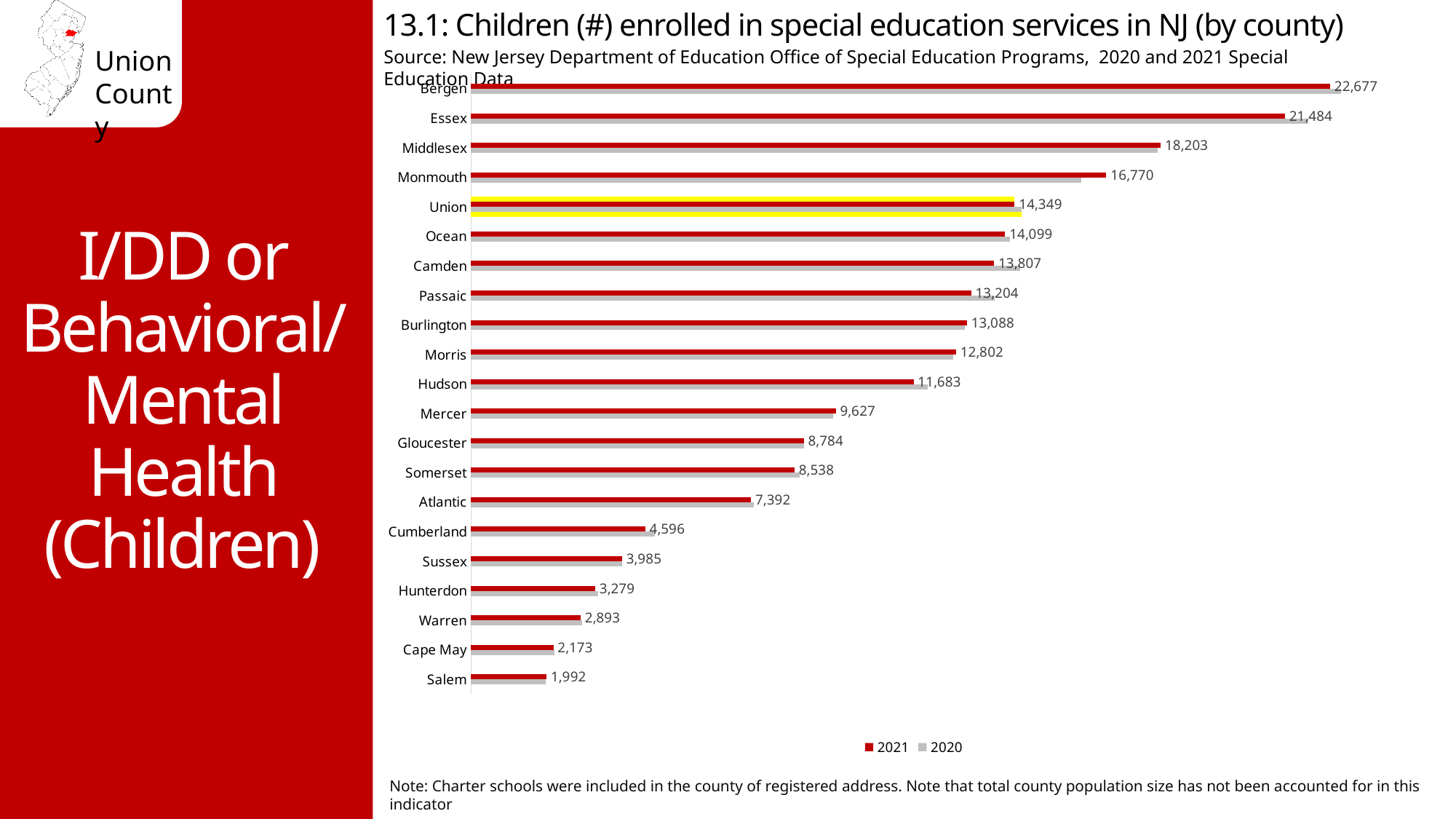
What is the 2021 value for Salem county? 1,992 What is the difference between the 2021 values for Bergen and Essex? 1,193 What is the 2021 value for Union county? 14,349 How many series does the legend list? 2 What kind of chart is shown on the slide? Bar chart How many counties are shown in the chart? 21 What is the 2021 value for Bergen county? 22,677 Which county has the lowest number of children enrolled in special education services in 2021? Salem Which county has the highest number of children enrolled in special education services in 2021? Bergen Which county has a larger 2021 value, Middlesex or Monmouth? Middlesex What is the difference between the 2021 values for Union and Ocean? 250 Which county's bars are highlighted in yellow on the chart? Union